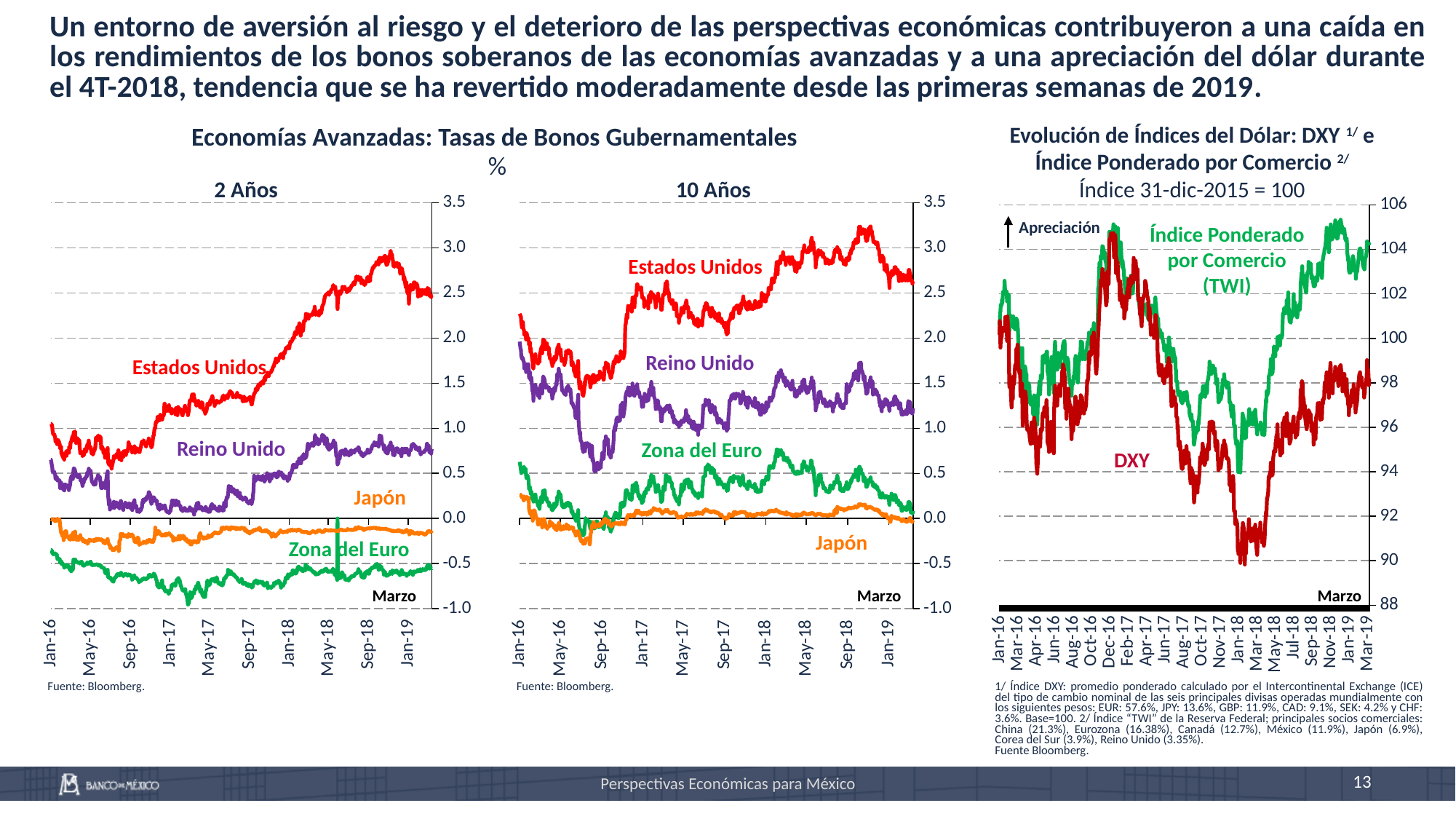
In the '10 Años' chart, is the value for Zona del Euro at Jan-19 greater or less than 0.5? less In the 'Evolución de Índices del Dólar' chart, what base is stated for the index? Índice 31-dic-2015 = 100 What kind of chart is the '2 Años' chart? line chart In the 'Evolución de Índices del Dólar' chart, which index is higher at Mar-19: DXY or Índice Ponderado por Comercio (TWI)? Índice Ponderado por Comercio (TWI) In the '2 Años' chart, which series has the lowest values over the period? Zona del Euro In the '2 Años' chart, how many series are plotted? 4 In the '2 Años' chart, is the value for Estados Unidos at Jan-19 greater or less than 2.0? greater In the '2 Años' chart, which series has the highest values at the end of the period (Jan-19)? Estados Unidos In the 'Evolución de Índices del Dólar' chart, does the DXY index rise or fall from Jan-18 to Mar-19? rise In the '10 Años' chart, which is larger at the end of the period: Reino Unido or Japón? Reino Unido